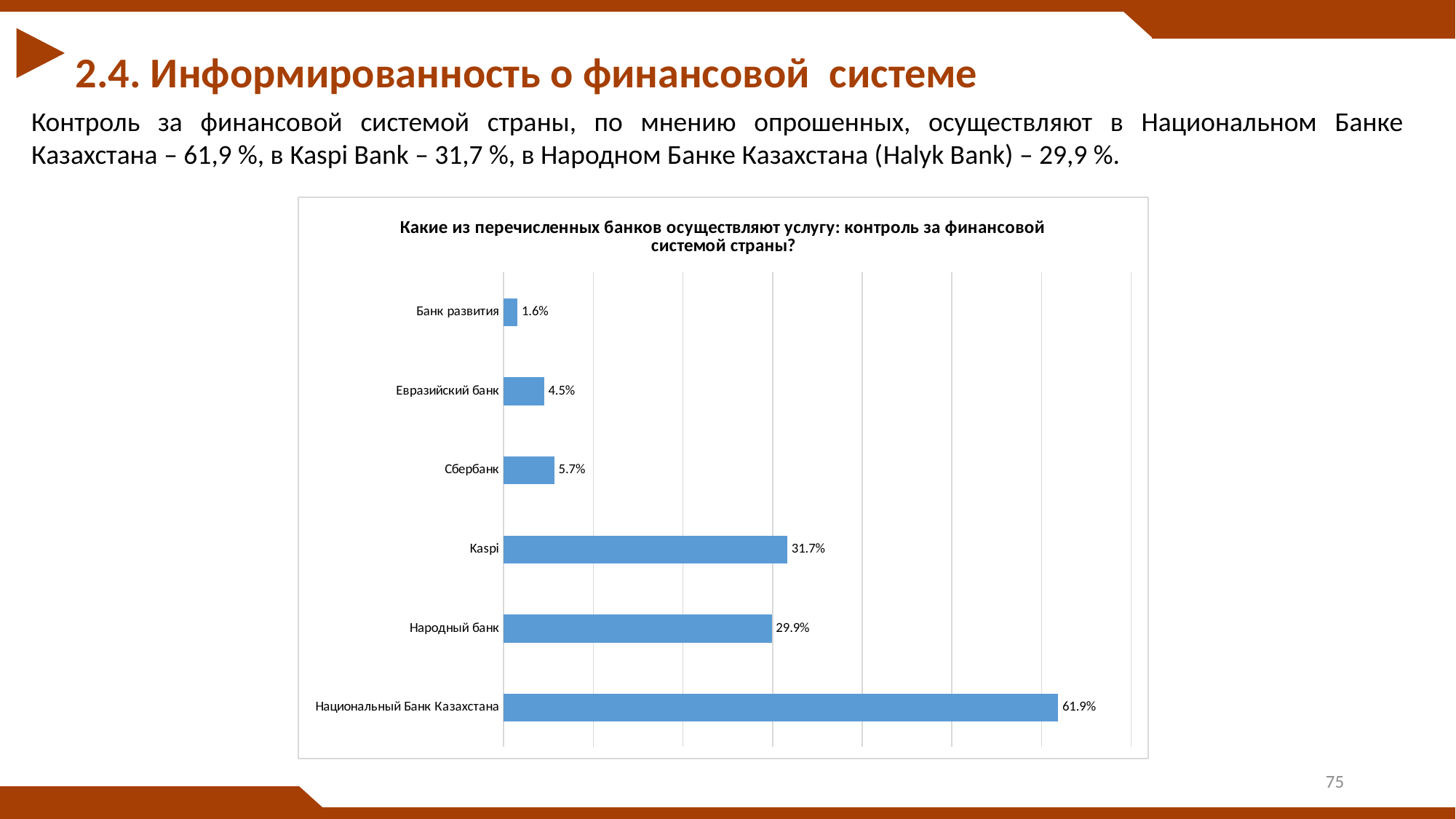
How many banks are shown in the chart? 6 Which has a larger value, Евразийский банк or Сбербанк? Сбербанк What value is shown for Национальный Банк Казахстана? 61.9% What is the difference between the values for Kaspi and Народный банк? 1.8% What value is shown for Kaspi? 31.7% What value is shown for Сбербанк? 5.7% What value is shown for Народный банк? 29.9% What type of chart is shown on the slide? Bar chart What value is shown for Банк развития? 1.6% Which bank has the lowest value in the chart? Банк развития What is the difference between the values for Национальный Банк Казахстана and Kaspi? 30.2% Which bank has the highest value in the chart? Национальный Банк Казахстана